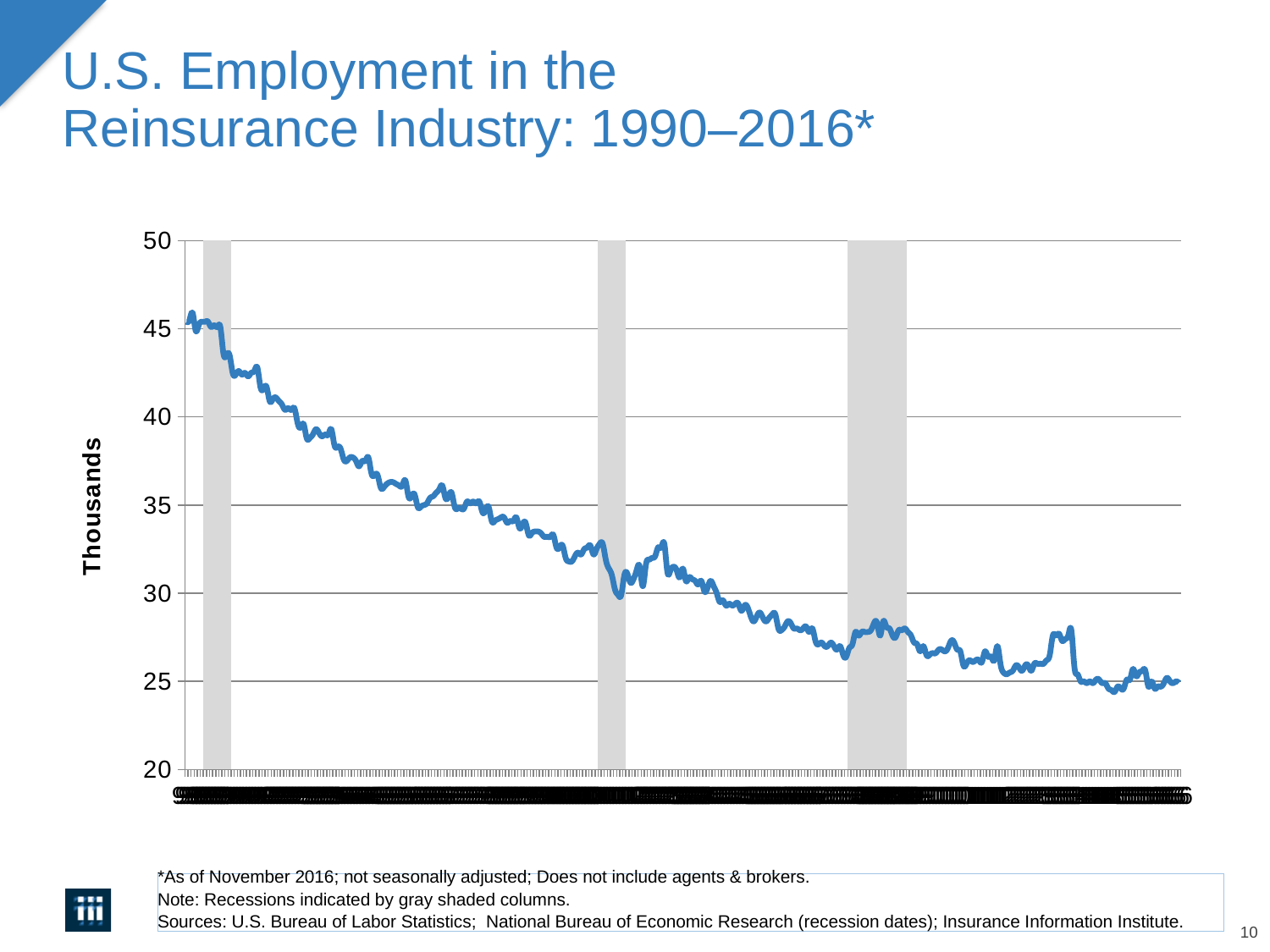
What is the highest value shown on the vertical axis? 50 What kind of chart is shown on the slide? line chart How many gray shaded recession columns are shown on the chart? 3 Is the highest point of the line greater or less than 45? greater What is the label on the vertical axis of the chart? Thousands Do the values in the chart generally rise or fall from left to right along the x axis? fall Is the value at the end of the line (right end) greater or less than 20? greater Is the value at the end of the line (right end) greater or less than 30? less